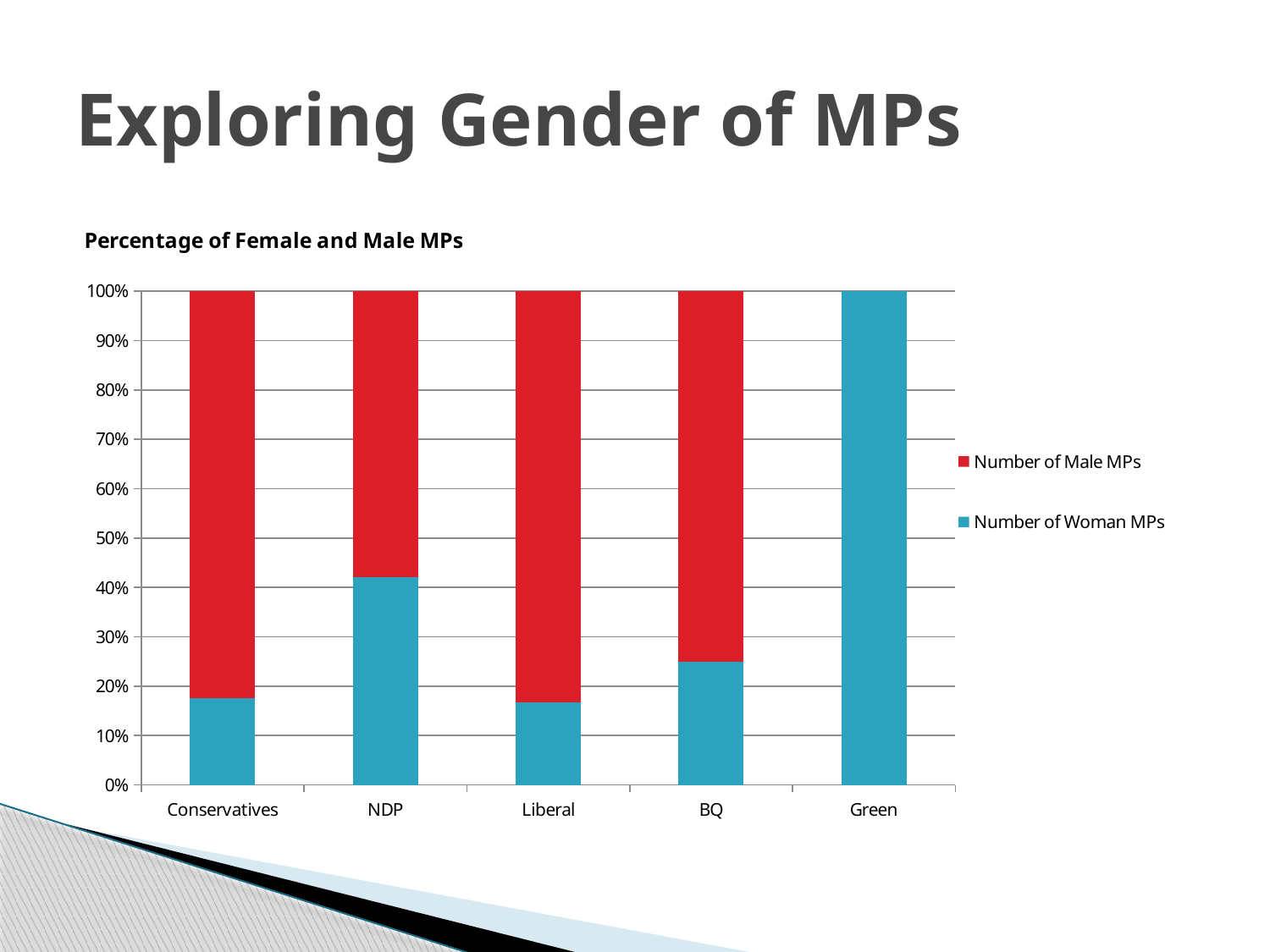
How many parties are shown on the x axis of the chart? 5 Which colour represents Number of Woman MPs in the chart? Blue Which party has a larger percentage of Male MPs, Conservatives or NDP? Conservatives What kind of chart is shown on the slide? Stacked bar chart Which party has the highest percentage of Woman MPs? Green How many series does the legend list? 2 Which party has the lowest percentage of Male MPs? Green Is the percentage of Woman MPs for Conservatives greater or less than 20%? less What is the percentage of Woman MPs for Green? 100% What is the title of the chart? Percentage of Female and Male MPs Is the percentage of Woman MPs for NDP greater or less than 40%? greater Which party has a larger percentage of Woman MPs, NDP or BQ? NDP